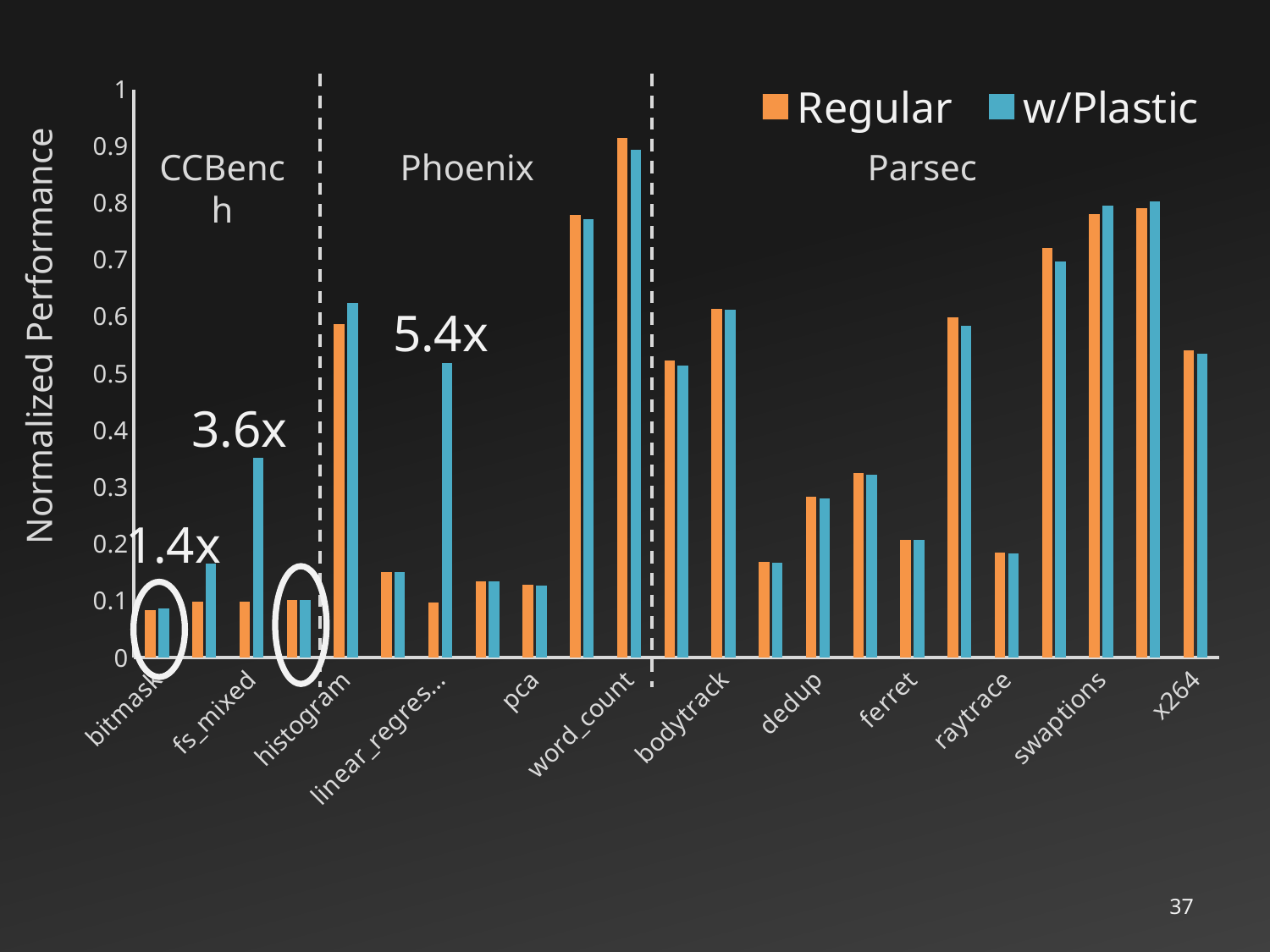
Which benchmark suite section is rightmost on the chart? Parsec How many series does the legend list? 2 What speedup annotation is shown in the Phoenix section of the chart? 5.4x What is the label of the y axis? Normalized Performance What speedup annotation is shown near the bitmask bars? 1.4x What kind of chart is shown on the slide? bar chart What speedup annotation is shown above the fs_mixed area of the chart? 3.6x What are the two series named in the legend? Regular and w/Plastic What is the maximum value shown on the y axis? 1 Is the tallest bar on the chart greater or less than 1? less Is the tallest bar on the chart greater or less than 0.8? greater